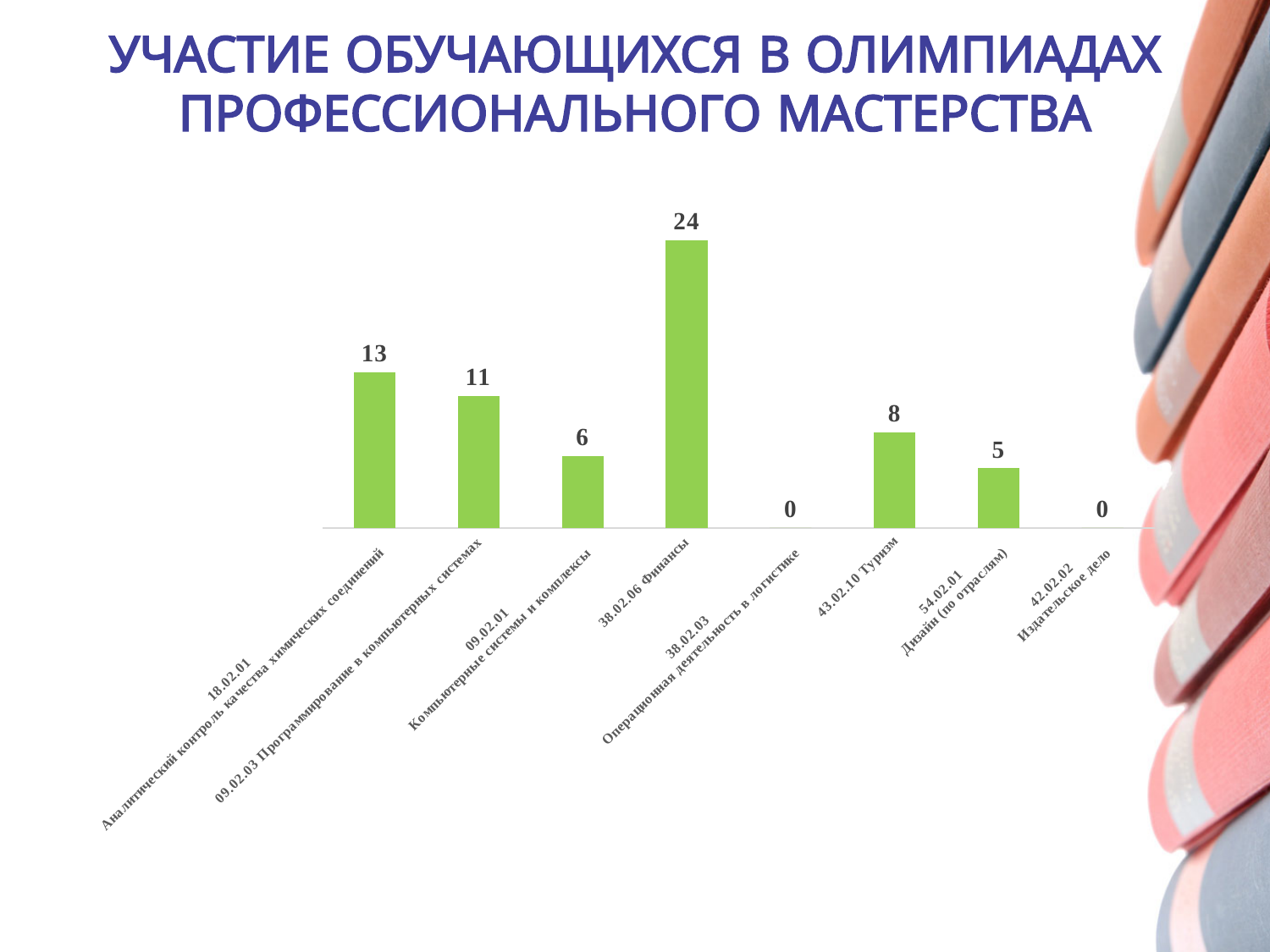
What is the value for 54.02.01 Дизайн (по отраслям)? 5 What is the value for 09.02.01 Компьютерные системы и комплексы? 6 How many categories are shown in the chart? 8 Which is larger: the value for 09.02.03 Программирование в компьютерных системах or the value for 43.02.10 Туризм? 09.02.03 Программирование в компьютерных системах What type of chart is shown on the slide? Bar chart How many categories have a value of 0? 2 What is the value for 43.02.10 Туризм? 8 Which category has the highest value? 38.02.06 Финансы What is the difference between the values for 38.02.06 Финансы and 18.02.01 Аналитический контроль качества химических соединений? 11 What is the value for 38.02.06 Финансы? 24 What is the difference between the values for 43.02.10 Туризм and 54.02.01 Дизайн (по отраслям)? 3 What colour are the bars in the chart? Green